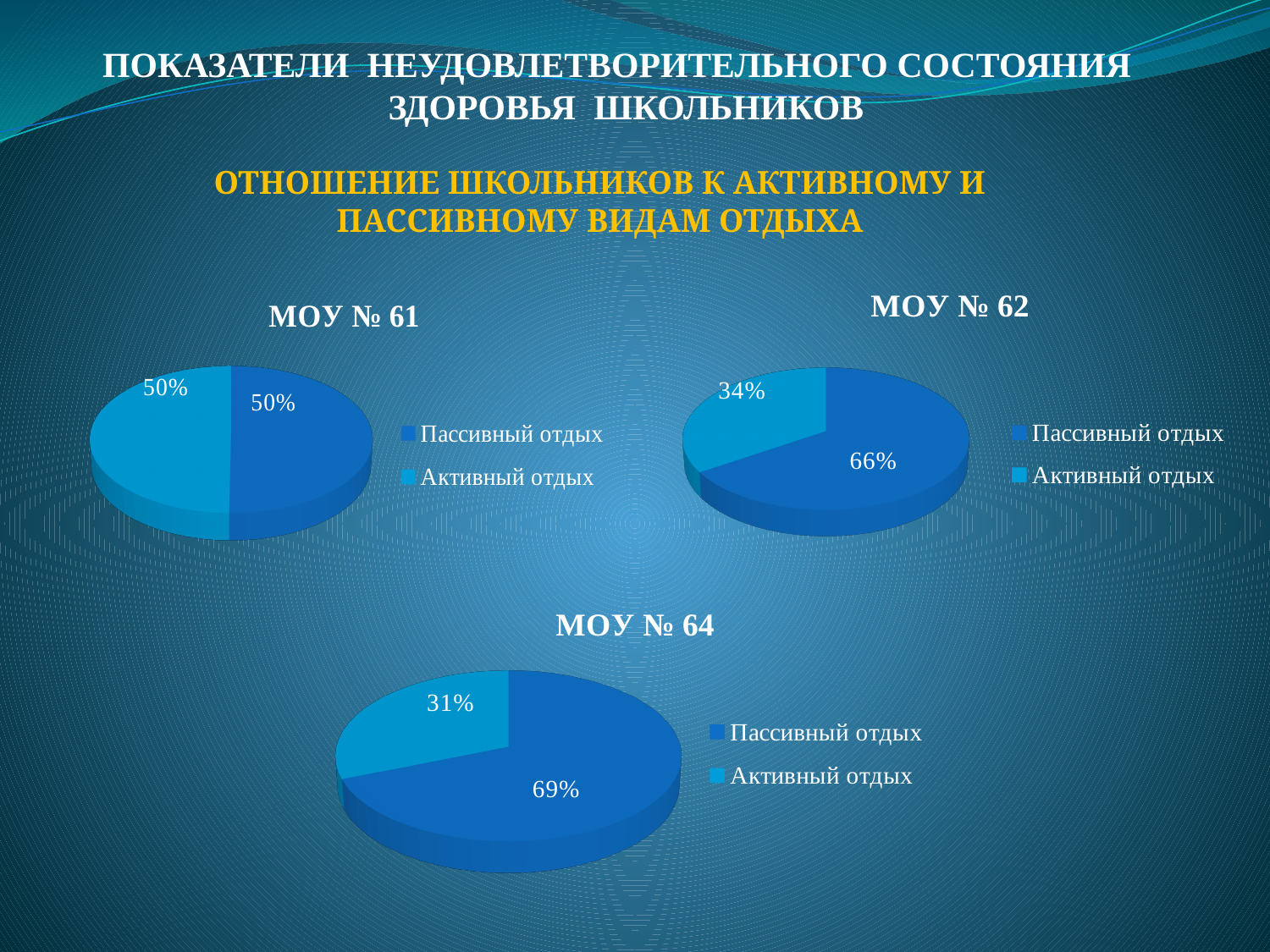
In the chart titled МОУ № 62, which is larger: Пассивный отдых or Активный отдых? Пассивный отдых In the chart titled МОУ № 62, what share is Активный отдых? 34% In the chart titled МОУ № 62, which category has the smallest slice? Активный отдых In the chart titled МОУ № 62, what share is Пассивный отдых? 66% In the chart titled МОУ № 64, what is the difference between the Пассивный отдых and Активный отдых shares? 38% In the chart titled МОУ № 64, which category has the largest slice? Пассивный отдых In the chart titled МОУ № 64, what share is Активный отдых? 31% In the chart titled МОУ № 61, what share is Активный отдых? 50% How many categories does the legend of the chart titled МОУ № 64 list? 2 How many pie charts are shown on the slide? 3 In the chart titled МОУ № 64, what share is Пассивный отдых? 69% What kind of chart is the one titled МОУ № 61? Pie chart